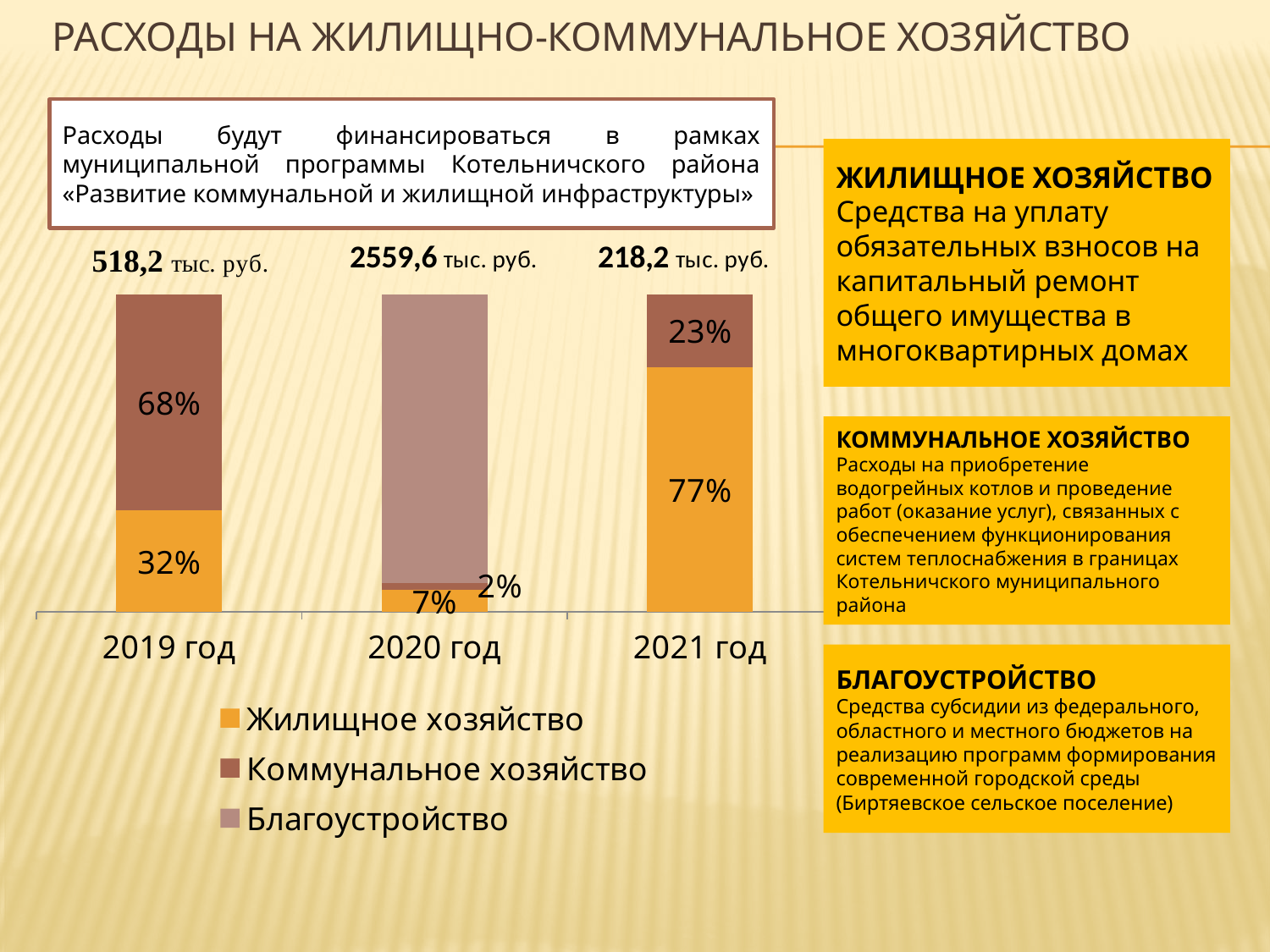
Which year has the largest total amount shown above its bar? 2020 год By how many percentage points does the Жилищное хозяйство share in 2021 exceed its share in 2019? 45 Which year has the smallest total amount shown above its bar? 2021 год What share of the 2020 bar is Жилищное хозяйство? 7% What share of the 2019 bar is Коммунальное хозяйство? 68% Which is larger in 2019: the share of Жилищное хозяйство or the share of Коммунальное хозяйство? Коммунальное хозяйство What share of the 2021 bar is Коммунальное хозяйство? 23% What share of the 2019 bar is Жилищное хозяйство? 32% What kind of chart is shown on the slide? Stacked bar chart What total amount is shown above the 2020 bar? 2559,6 тыс. руб. How many series does the legend list? 3 What share of the 2021 bar is Жилищное хозяйство? 77%